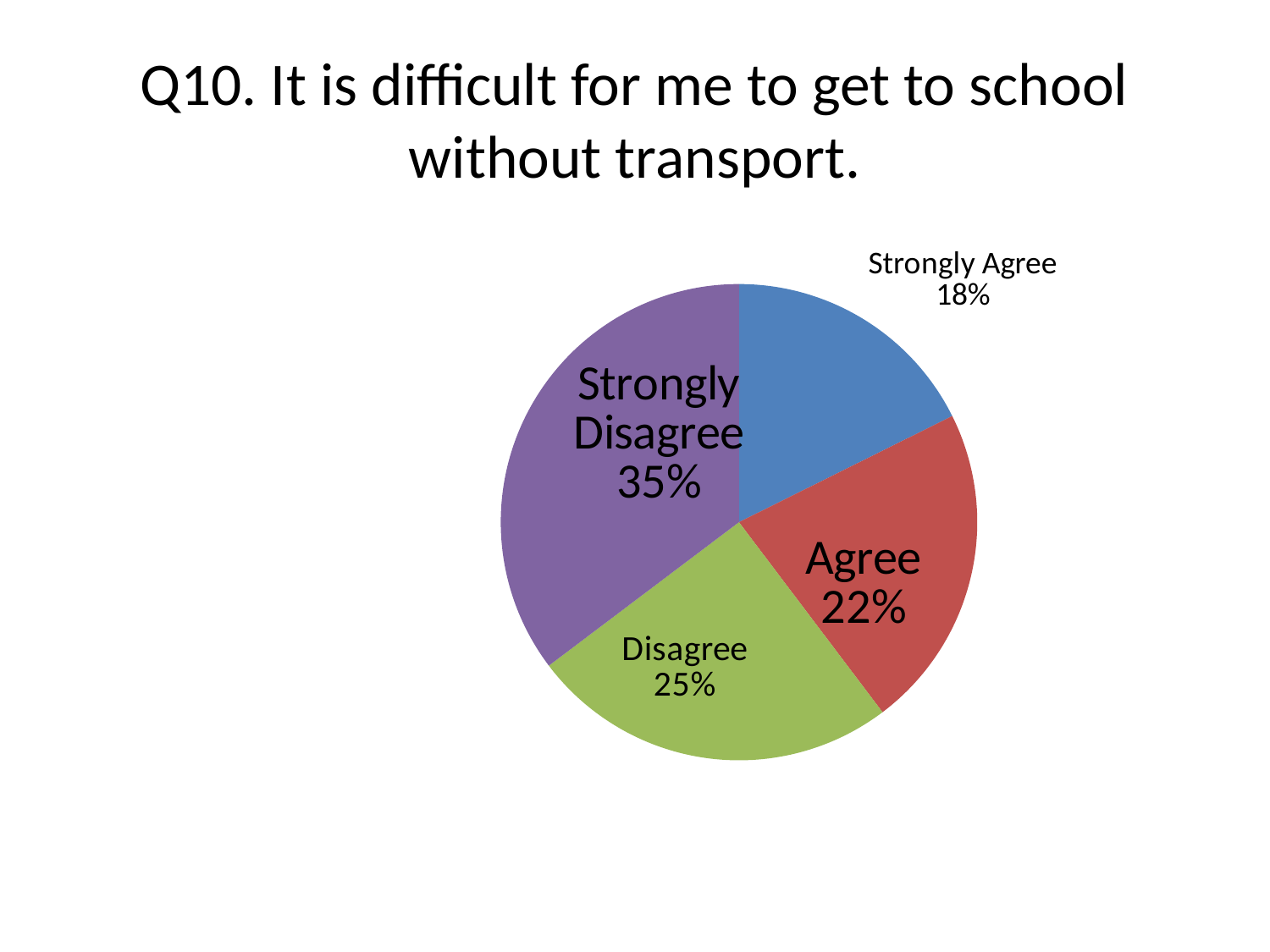
What percentage of respondents chose Strongly Disagree? 35% How many slices does the pie chart have? 4 What is the difference in percentage points between Strongly Disagree and Strongly Agree? 17 Which is larger, the share for Disagree or the share for Agree? Disagree Which response has the largest share of the pie? Strongly Disagree Which response has the smallest share of the pie? Strongly Agree What is the combined percentage of Strongly Agree and Agree? 40% What percentage of respondents chose Strongly Agree? 18% What kind of chart is shown on the slide? pie chart What percentage of respondents chose Agree? 22% What is the title of the chart? Q10. It is difficult for me to get to school without transport. What percentage of respondents chose Disagree? 25%